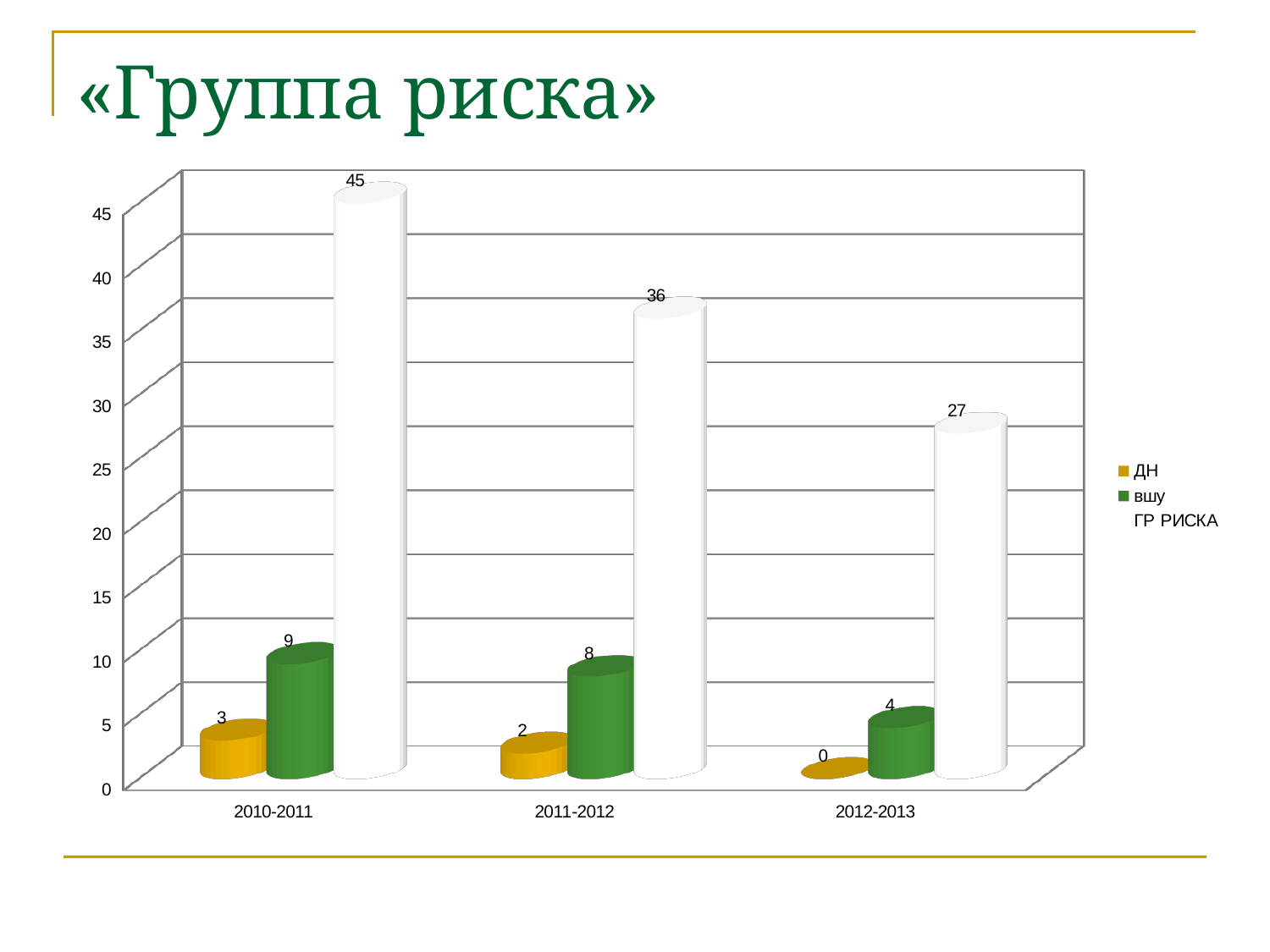
What kind of chart is shown on the slide? Bar chart Which is larger: вшу in 2010-2011 or вшу in 2011-2012? вшу in 2010-2011 What is the value for вшу in 2012-2013? 4 How many series does the legend list? 3 How many periods are shown on the x axis? 3 What is the value for ДН in 2011-2012? 2 Do the ГР РИСКА values rise or fall from 2010-2011 to 2012-2013? Fall Which period has the highest value for ГР РИСКА? 2010-2011 What is the value for ДН in 2012-2013? 0 What is the difference between the ГР РИСКА values for 2010-2011 and 2012-2013? 18 Which period has the lowest value for вшу? 2012-2013 What is the value for ГР РИСКА in 2010-2011? 45